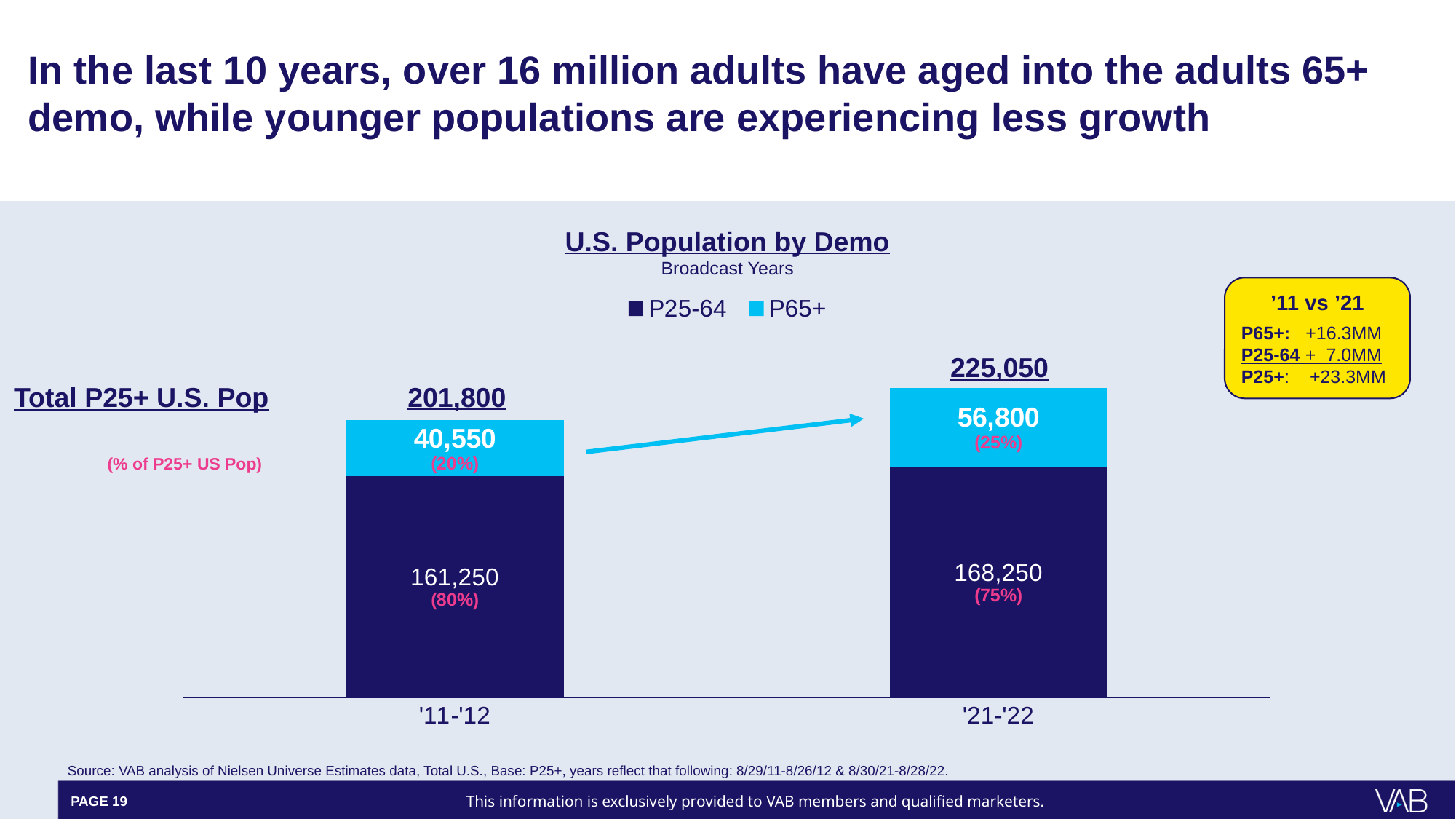
What is the total of the stacked bar for '21-'22? 225,050 What is the value for P25-64 in '21-'22? 168,250 What is the total of the stacked bar for '11-'12? 201,800 What is the title of the chart? U.S. Population by Demo Which period has the larger P25-64 value, '11-'12 or '21-'22? '21-'22 What is the difference between the P65+ values for '21-'22 and '11-'12? 16,250 What is the value for P65+ in '11-'12? 40,550 What kind of chart is shown on the slide? Stacked bar chart What is the value for P65+ in '21-'22? 56,800 What is the value for P25-64 in '11-'12? 161,250 What percentage of the P25+ U.S. population does P65+ represent in '21-'22? 25% How many series does the legend list? 2